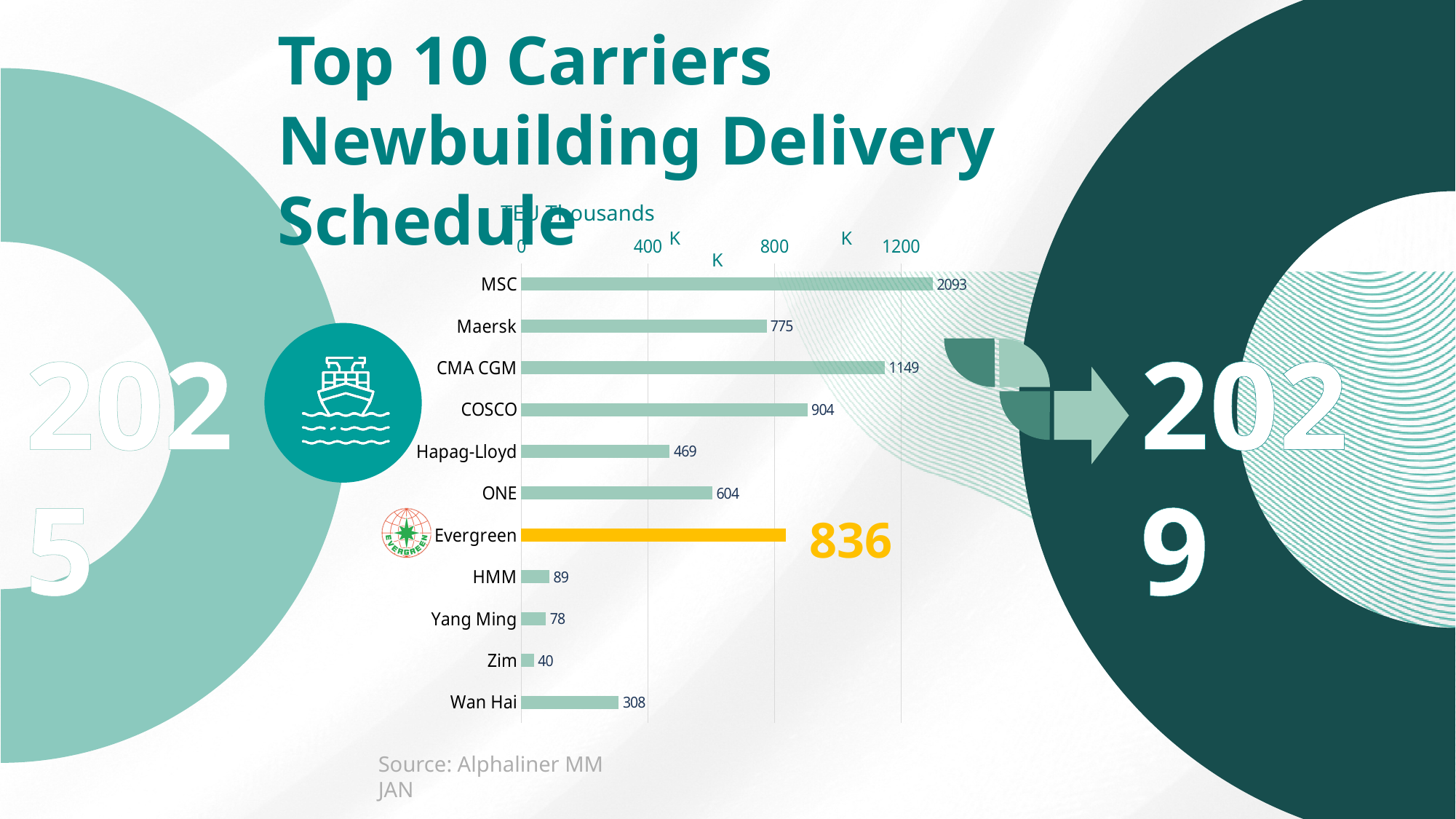
What is the value for Wan Hai? 308 How many carriers are shown in the chart? 11 What is the value for MSC? 2093 What is the value for Evergreen? 836 What kind of chart is shown on the slide? bar chart What is the value for CMA CGM? 1149 What unit is shown on the chart's axis label? TEU Thousands Which carrier has the highest value? MSC Which is larger, the value for ONE or the value for Hapag-Lloyd? ONE What is the difference between the values for COSCO and Maersk? 129 Is the value for Maersk greater or less than 800? less Which carrier has the lowest value? Zim